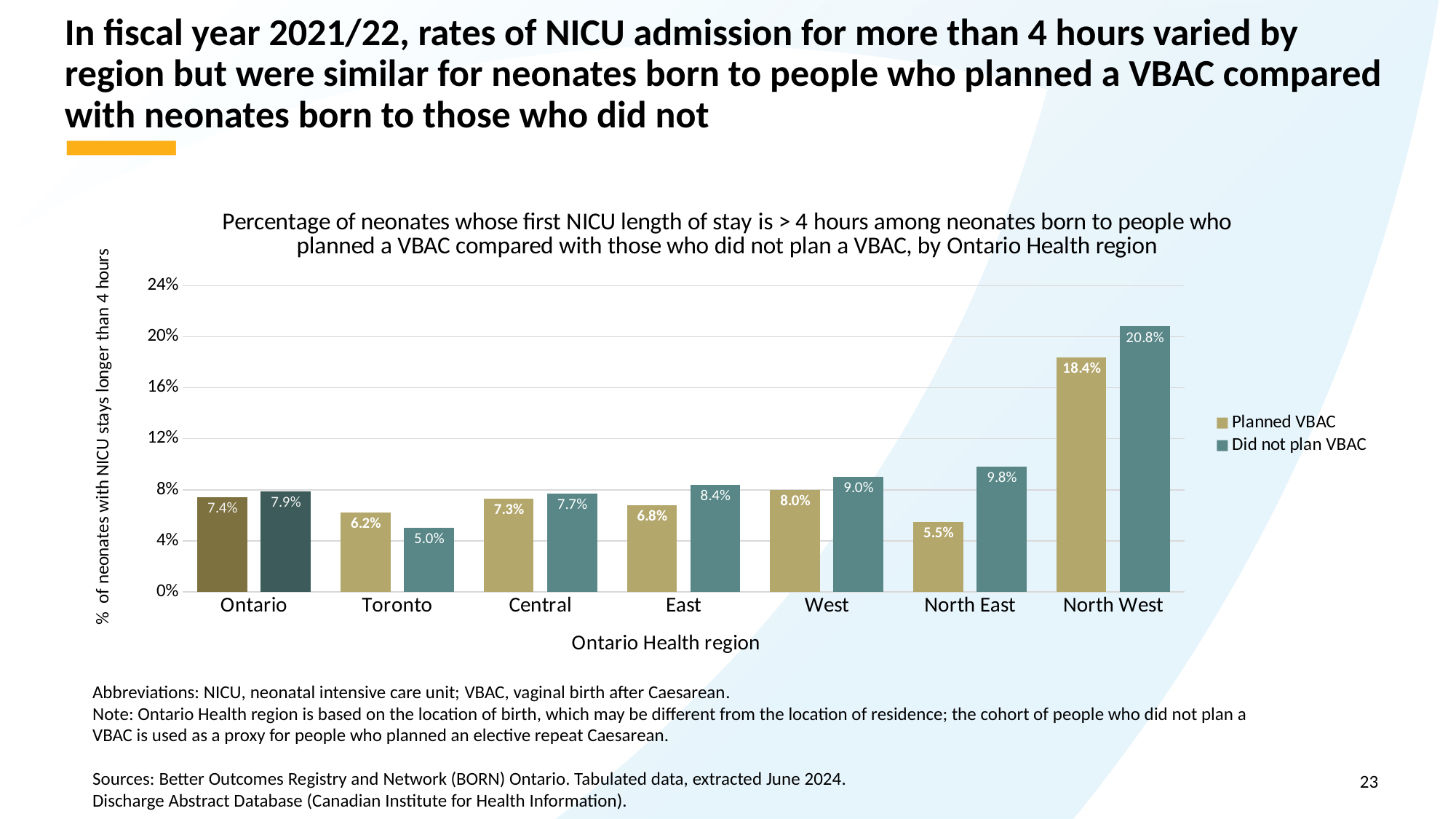
What is the Planned VBAC value for Ontario? 7.4% Which is larger for Toronto: the Planned VBAC value or the Did not plan VBAC value? Planned VBAC Is the Did not plan VBAC value for North West greater or less than 20%? greater What is the Did not plan VBAC value for Toronto? 5.0% What is the difference between the Did not plan VBAC and Planned VBAC values for North West? 2.4% What is the Planned VBAC value for North West? 18.4% How many series does the legend list? 2 Which region has the highest Did not plan VBAC value? North West What is the label of the x axis? Ontario Health region What kind of chart is shown on the slide? Bar chart How many regions are shown on the x axis? 7 Which region has the lowest Planned VBAC value? North East